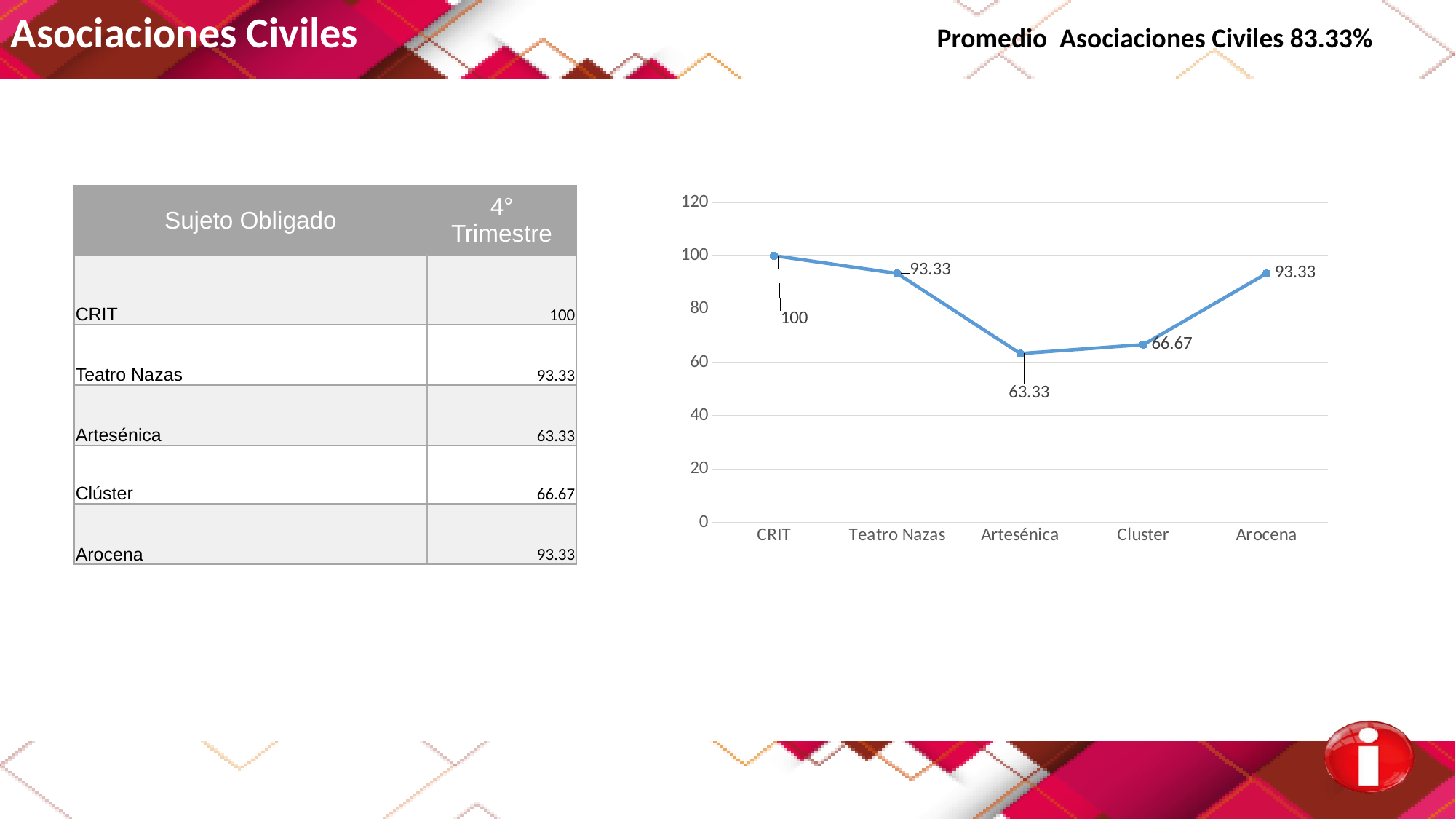
Which is larger, the value for Cluster or the value for Arocena? Arocena What is the value for CRIT in the chart? 100 What is the difference between the values for Teatro Nazas and Cluster? 26.66 How many categories are plotted on the x axis of the chart? 5 Does the value rise or fall from Artesénica to Arocena? Rise What is the value for Arocena in the chart? 93.33 What is the value for Cluster in the chart? 66.67 What is the difference between the values for CRIT and Artesénica? 36.67 Which category has the lowest value in the chart? Artesénica What is the value for Artesénica in the chart? 63.33 What kind of chart is shown on the slide? Line chart Which category has the highest value in the chart? CRIT